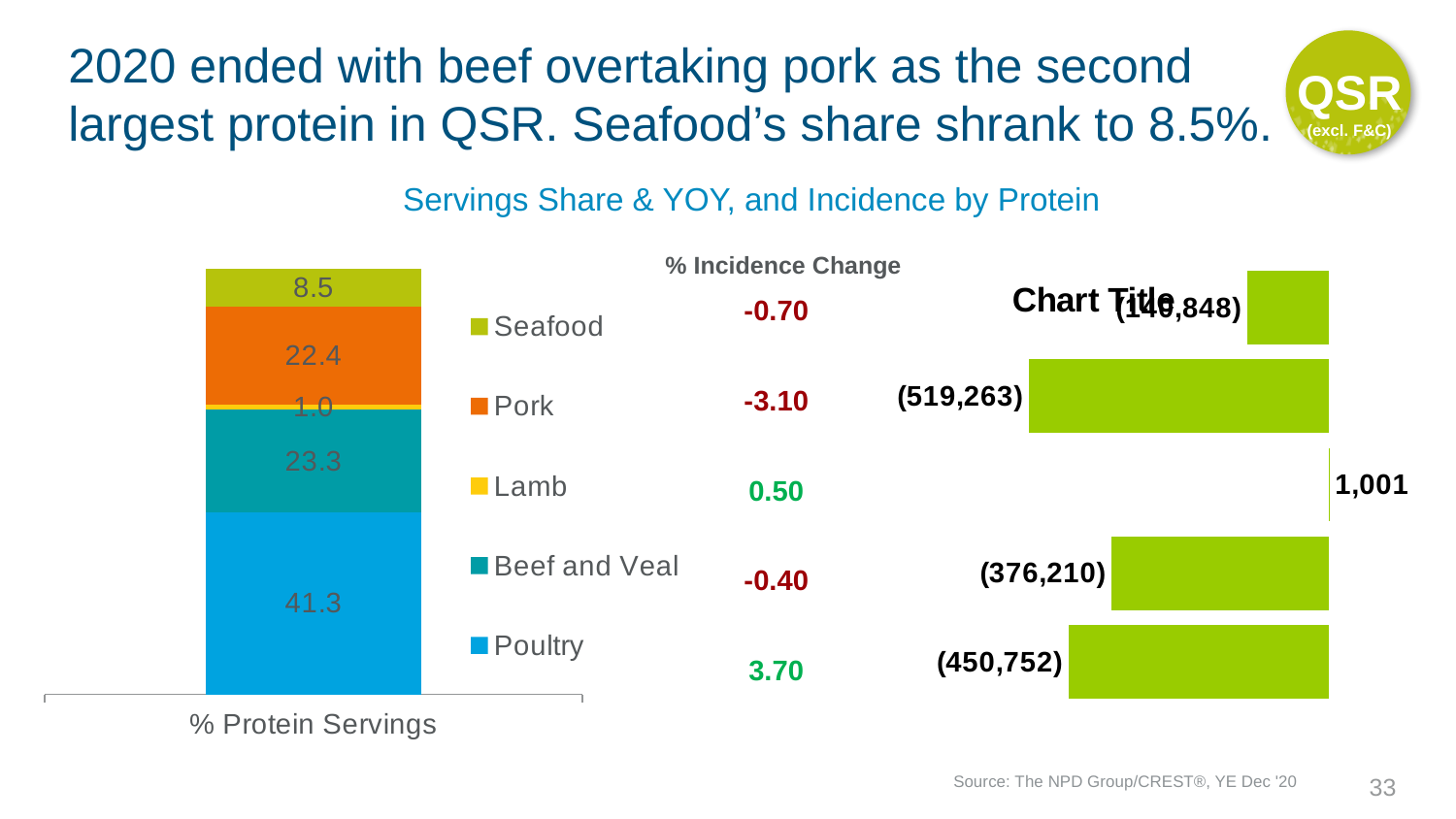
In the stacked bar chart on the left (% Protein Servings), what is the value for Pork? 22.4 In the stacked bar chart on the left (% Protein Servings), what is the value for Seafood? 8.5 How many series does the legend of the stacked bar chart on the left list? 5 In the stacked bar chart on the left (% Protein Servings), which protein has the smallest share? Lamb In the stacked bar chart on the left (% Protein Servings), what is the difference between the Poultry and Beef and Veal values? 18.0 In the stacked bar chart on the left (% Protein Servings), which is larger, Beef and Veal or Pork? Beef and Veal In the stacked bar chart on the left (% Protein Servings), what is the value for Lamb? 1.0 In the stacked bar chart on the left (% Protein Servings), which protein has the largest share? Poultry What type of chart is the chart on the left (% Protein Servings)? Stacked bar chart In the bar chart on the right (titled 'Chart Title'), what is the data label on the bottom bar? (450,752) In the stacked bar chart on the left (% Protein Servings), what is the value for Poultry? 41.3 In the bar chart on the right (titled 'Chart Title'), what is the data label on the second bar from the top? (519,263)